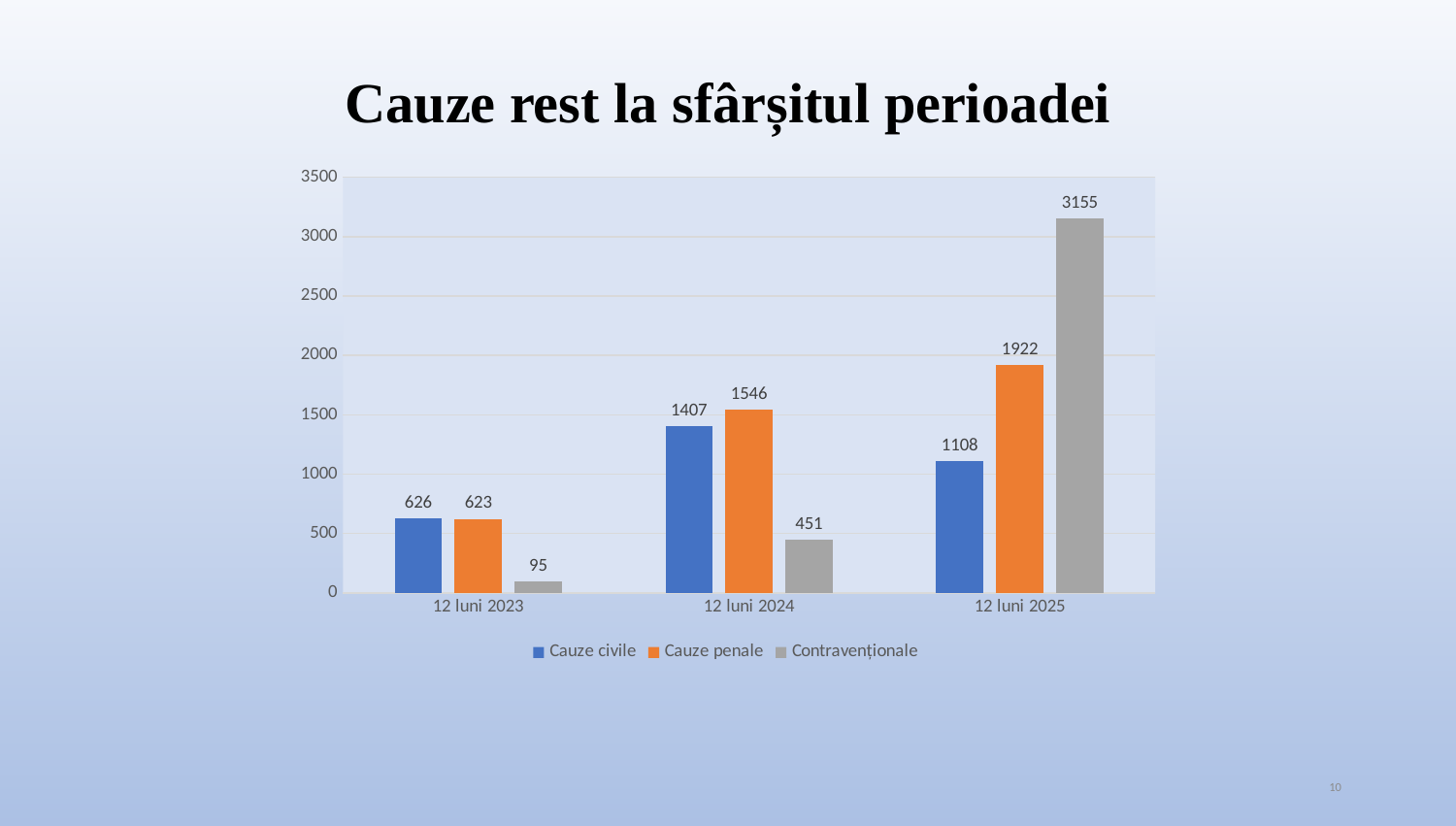
Is the value for Contravenționale in 12 luni 2025 greater or less than 3000? greater How many series does the legend list? 3 Which period has the lowest value for Cauze civile? 12 luni 2023 What is the value for Cauze penale in 12 luni 2025? 1922 What is the value for Contravenționale in 12 luni 2023? 95 How many periods are shown on the x axis? 3 What is the value for Cauze civile in 12 luni 2024? 1407 Which period has the highest value for Contravenționale? 12 luni 2025 Do the values for Contravenționale rise or fall from 12 luni 2023 to 12 luni 2025? rise What kind of chart is shown on the slide? bar chart Which is larger in 12 luni 2024: Cauze civile or Cauze penale? Cauze penale What is the difference between Cauze penale and Cauze civile in 12 luni 2025? 814